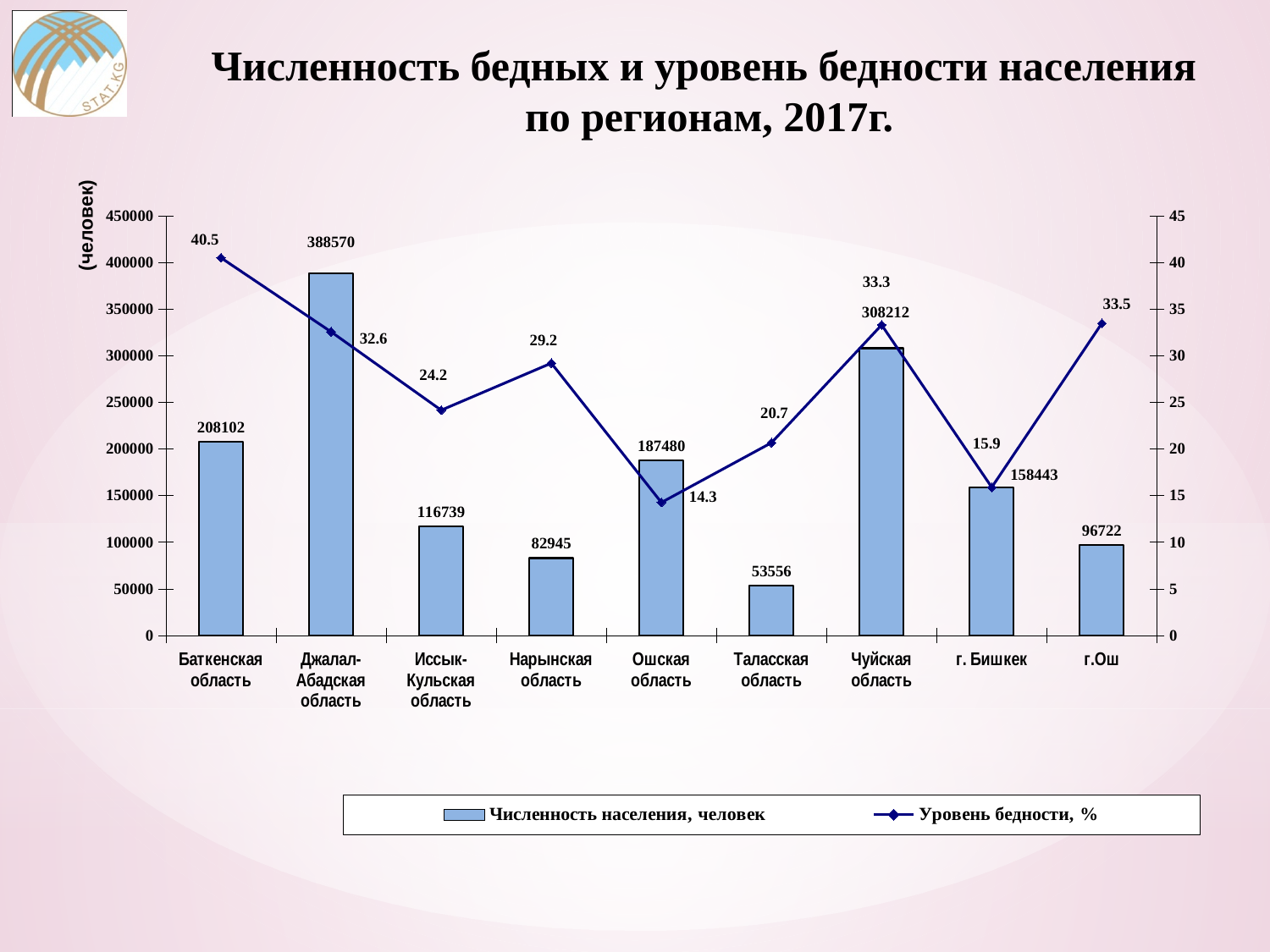
Which region has the lowest poverty rate (Уровень бедности, %)? Ошская область Which region has the lowest number of poor people (Численность населения, человек)? Таласская область What is the poverty rate (Уровень бедности, %) for г. Бишкек? 15.9 What is the difference in the number of poor people between Чуйская область and Ошская область? 120732 What kind of chart is used for the series Численность населения, человек? Bar chart Which has a higher poverty rate, Нарынская область or Иссык-Кульская область? Нарынская область What is the difference in poverty rate between г.Ош and Чуйская область? 0.2 How many series does the legend list? 2 What is the poverty rate (Уровень бедности, %) for Баткенская область? 40.5 Which region has the highest number of poor people (Численность населения, человек)? Джалал-Абадская область How many regions are shown on the x axis? 9 What is the number of poor people (Численность населения, человек) in Джалал-Абадская область? 388570